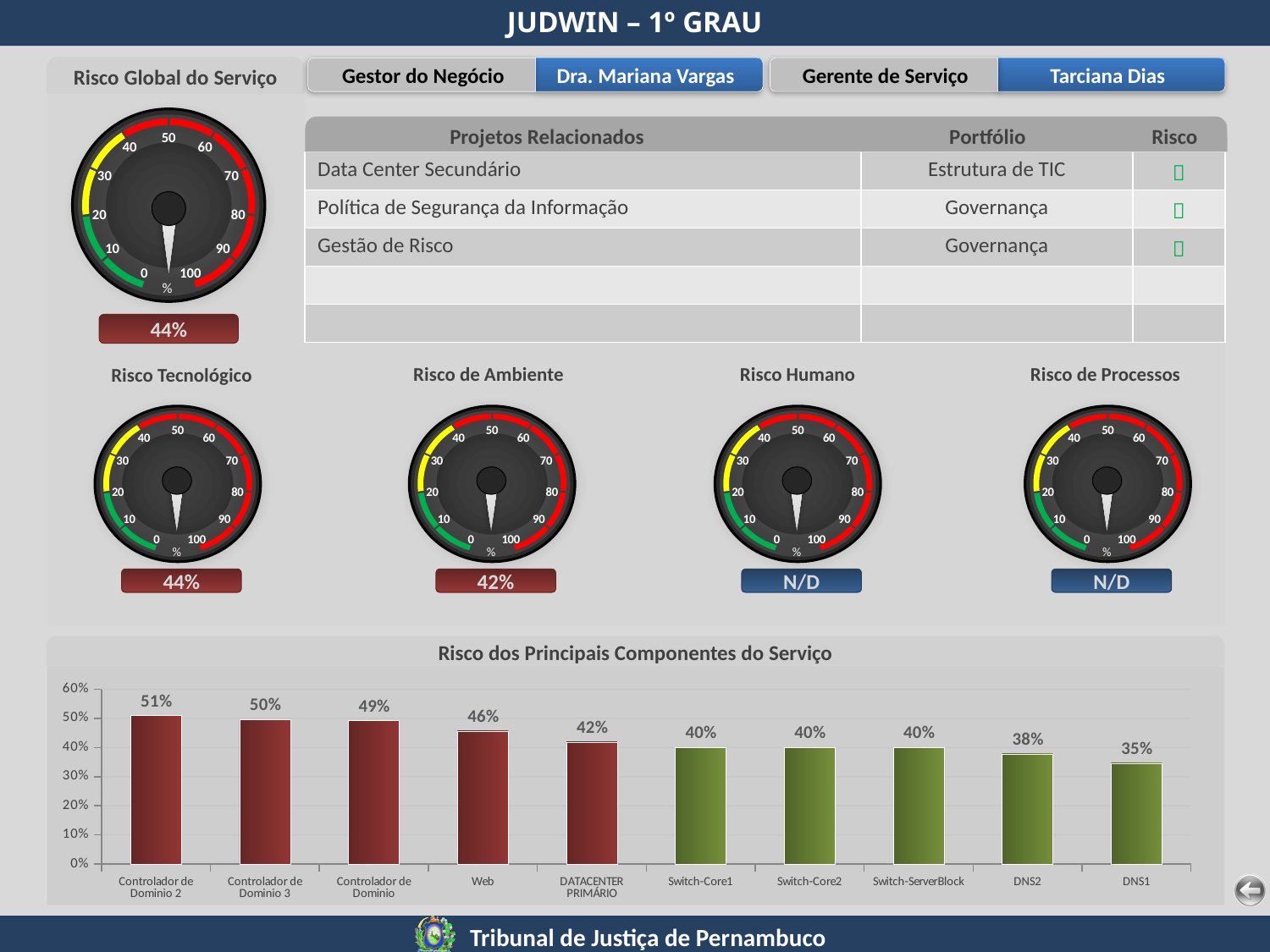
How many components are shown in the chart 'Risco dos Principais Componentes do Serviço'? 10 In the chart 'Risco dos Principais Componentes do Serviço', what is the difference between Controlador de Dominio 2 and DNS1? 16% In the chart 'Risco dos Principais Componentes do Serviço', which component has the lowest value? DNS1 In the chart 'Risco dos Principais Componentes do Serviço', do the values rise or fall from left to right? Fall What kind of chart is 'Risco dos Principais Componentes do Serviço'? Bar chart What value does the 'Risco Global do Serviço' gauge show? 44% In the chart 'Risco dos Principais Componentes do Serviço', what is the value for DNS2? 38% In the chart 'Risco dos Principais Componentes do Serviço', which is larger, Web or Switch-Core1? Web In the chart 'Risco dos Principais Componentes do Serviço', what is the value for DATACENTER PRIMÁRIO? 42% In the chart 'Risco dos Principais Componentes do Serviço', what is the value for Web? 46% What value does the 'Risco de Ambiente' gauge show? 42% In the chart 'Risco dos Principais Componentes do Serviço', which component has the highest value? Controlador de Dominio 2